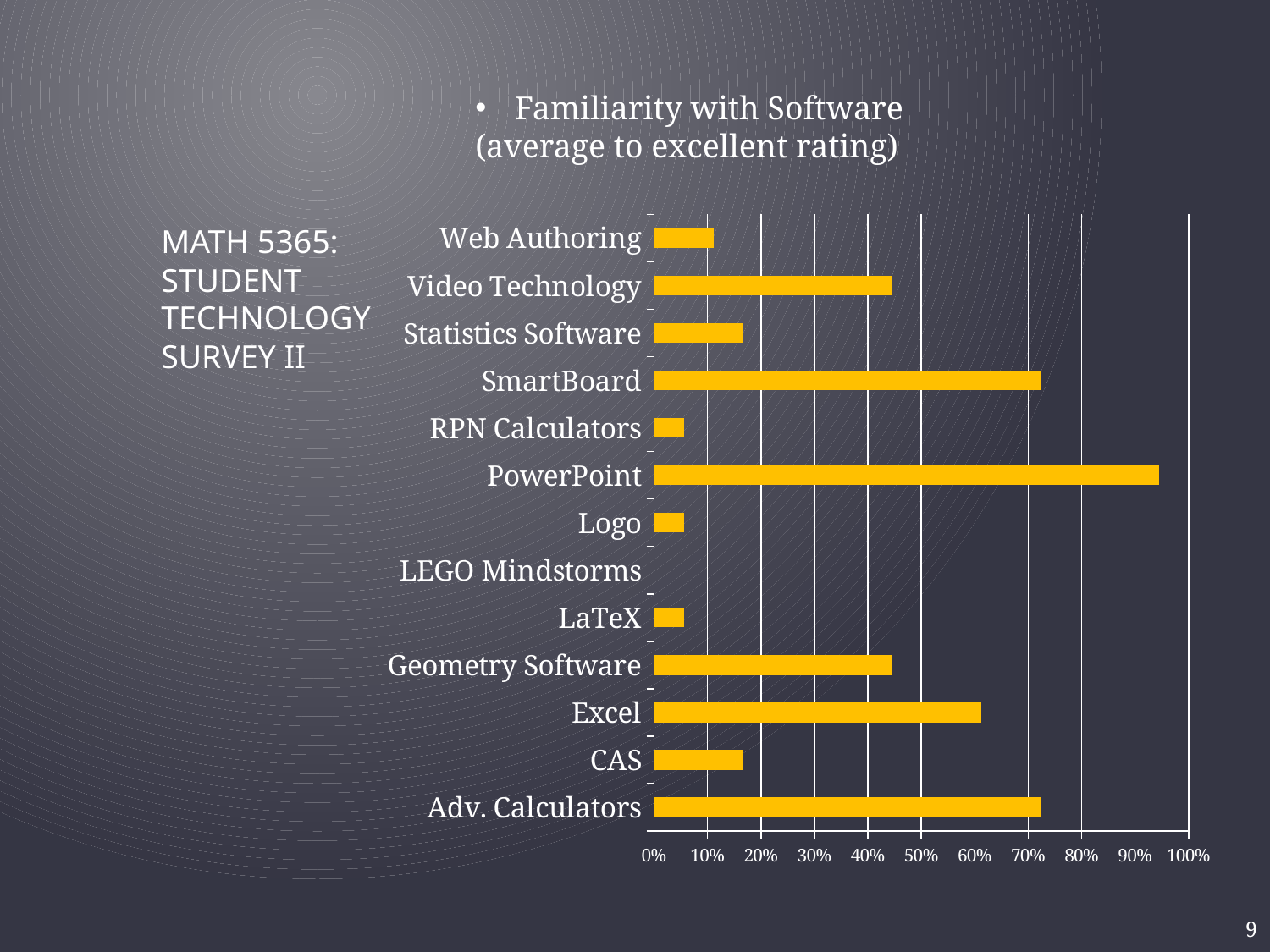
Which software category has the lowest familiarity rating? LEGO Mindstorms Which has a higher value, Excel or Video Technology? Excel What kind of chart is shown on the slide? bar chart Is the value for SmartBoard greater or less than 80%? less Is the value for Web Authoring greater or less than 20%? less How many software categories are plotted in the chart? 13 Is the value for Excel greater or less than 50%? greater What is the title of the chart? Familiarity with Software (average to excellent rating) Which has a higher value, Statistics Software or Geometry Software? Geometry Software Which software category has the highest familiarity rating? PowerPoint